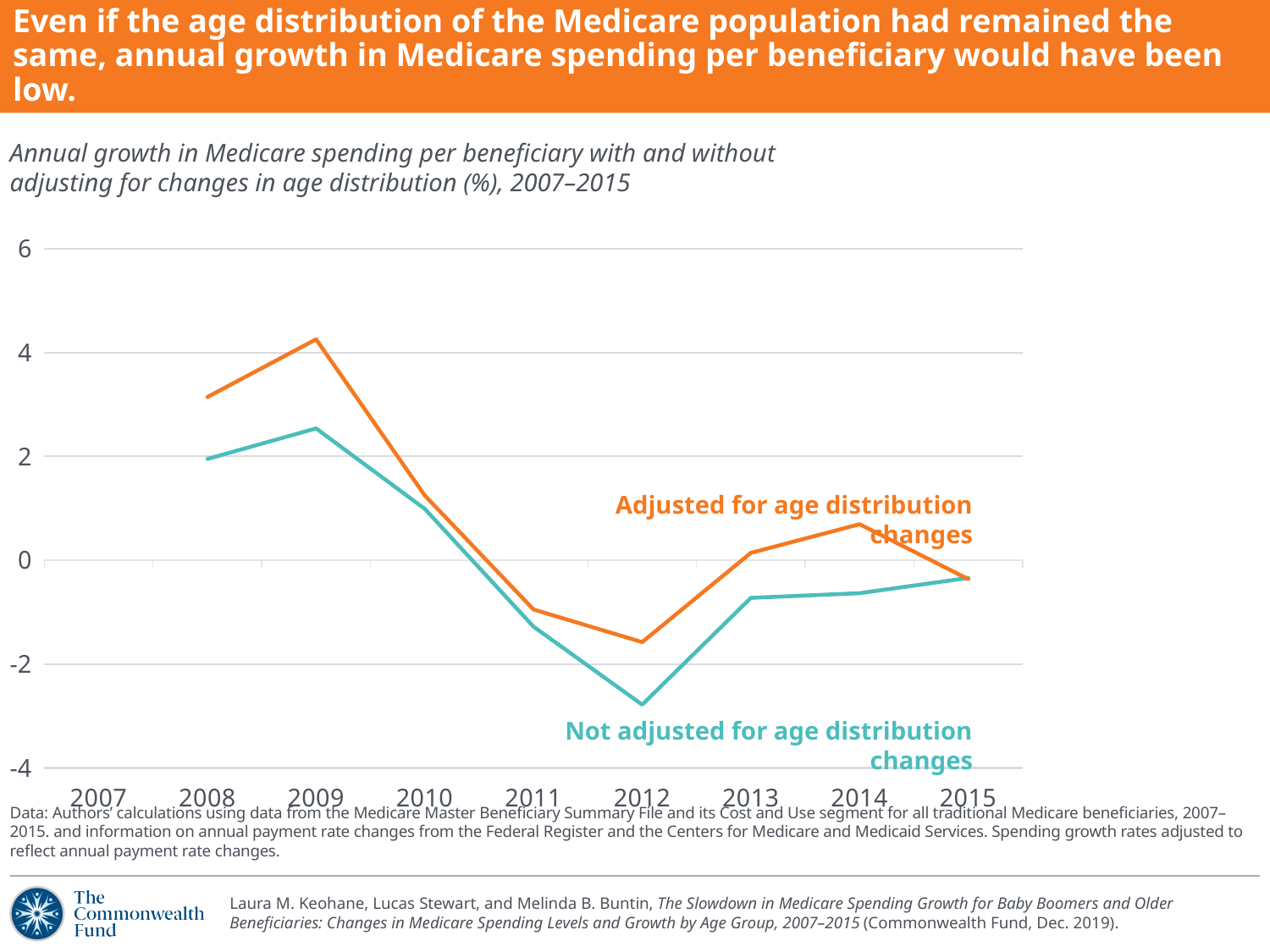
How many year labels appear along the x axis? 9 What colour is the 'Not adjusted for age distribution changes' line? Teal Is the value for 'Not adjusted for age distribution changes' in 2009 greater or less than 2? greater In which year does the 'Not adjusted for age distribution changes' line reach its lowest value? 2012 Is the value for 'Adjusted for age distribution changes' in 2008 greater or less than 2? greater How many series are plotted on the chart? 2 In which year does the 'Adjusted for age distribution changes' line reach its highest value? 2009 Between 2009 and 2012, do the values of the 'Adjusted for age distribution changes' line rise or fall? Fall In 2009, which series has the larger value: 'Adjusted for age distribution changes' or 'Not adjusted for age distribution changes'? Adjusted for age distribution changes Is the value for 'Adjusted for age distribution changes' in 2012 greater or less than 0? less What kind of chart is shown on the slide? Line chart